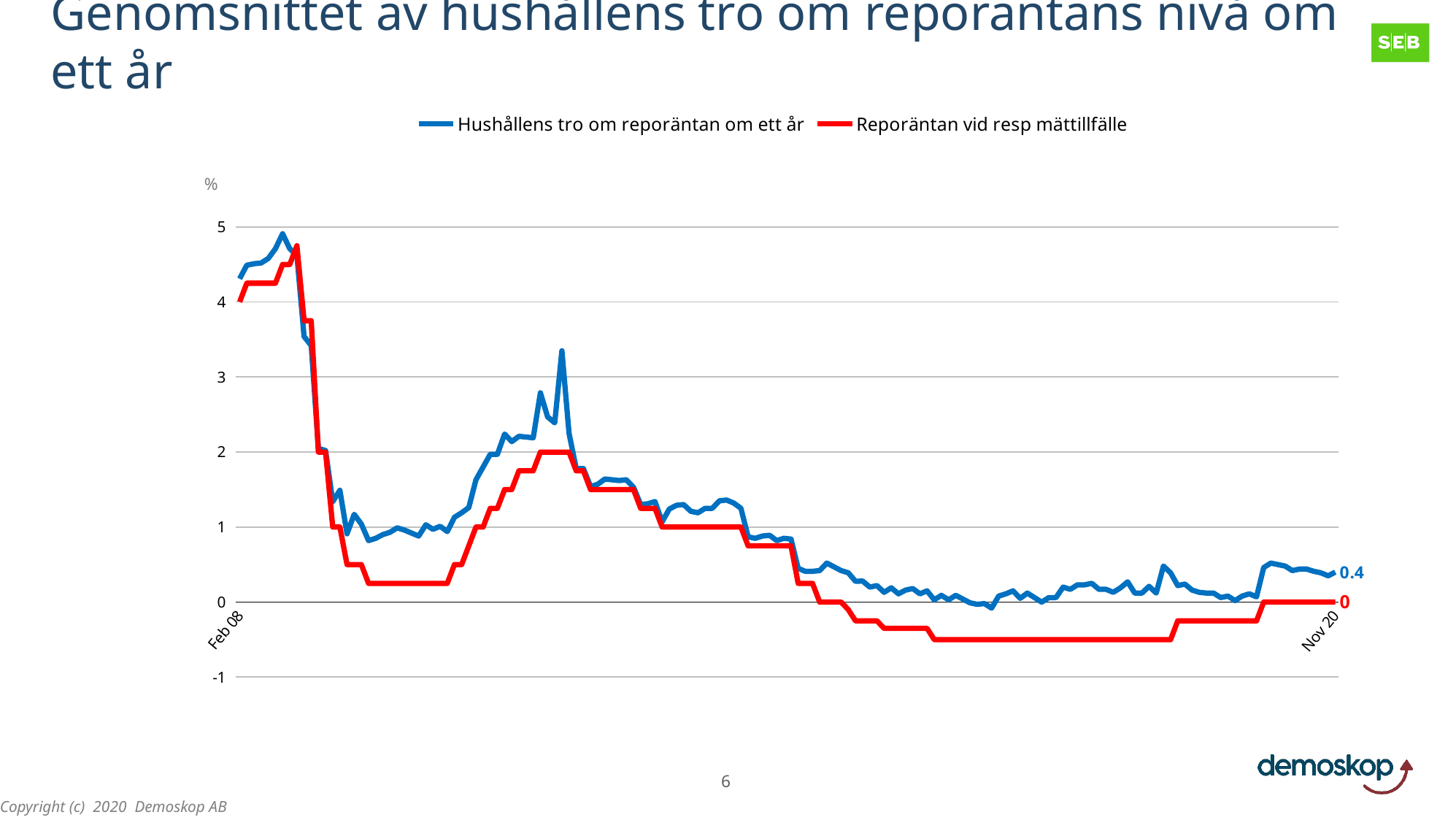
Overall, does the 'Hushållens tro om reporäntan om ett år' line rise or fall from Feb 08 to Nov 20? fall Is the lowest value of 'Reporäntan vid resp mättillfälle' greater or less than 0? less What is the final value (Nov 20) of the series 'Reporäntan vid resp mättillfälle'? 0 What unit is shown on the y axis of the chart? % At Nov 20, which series has the higher value: 'Hushållens tro om reporäntan om ett år' or 'Reporäntan vid resp mättillfälle'? Hushållens tro om reporäntan om ett år What is the final value (Nov 20) of the series 'Hushållens tro om reporäntan om ett år'? 0.4 At Nov 20, what is the difference between 'Hushållens tro om reporäntan om ett år' and 'Reporäntan vid resp mättillfälle'? 0.4 What is the first x-axis label shown on the chart? Feb 08 What kind of chart is shown on the slide? line chart How many series does the legend list? 2 Is the value of 'Reporäntan vid resp mättillfälle' at Feb 08 greater or less than 3? greater Is the value of 'Hushållens tro om reporäntan om ett år' at Feb 08 greater or less than 4? greater